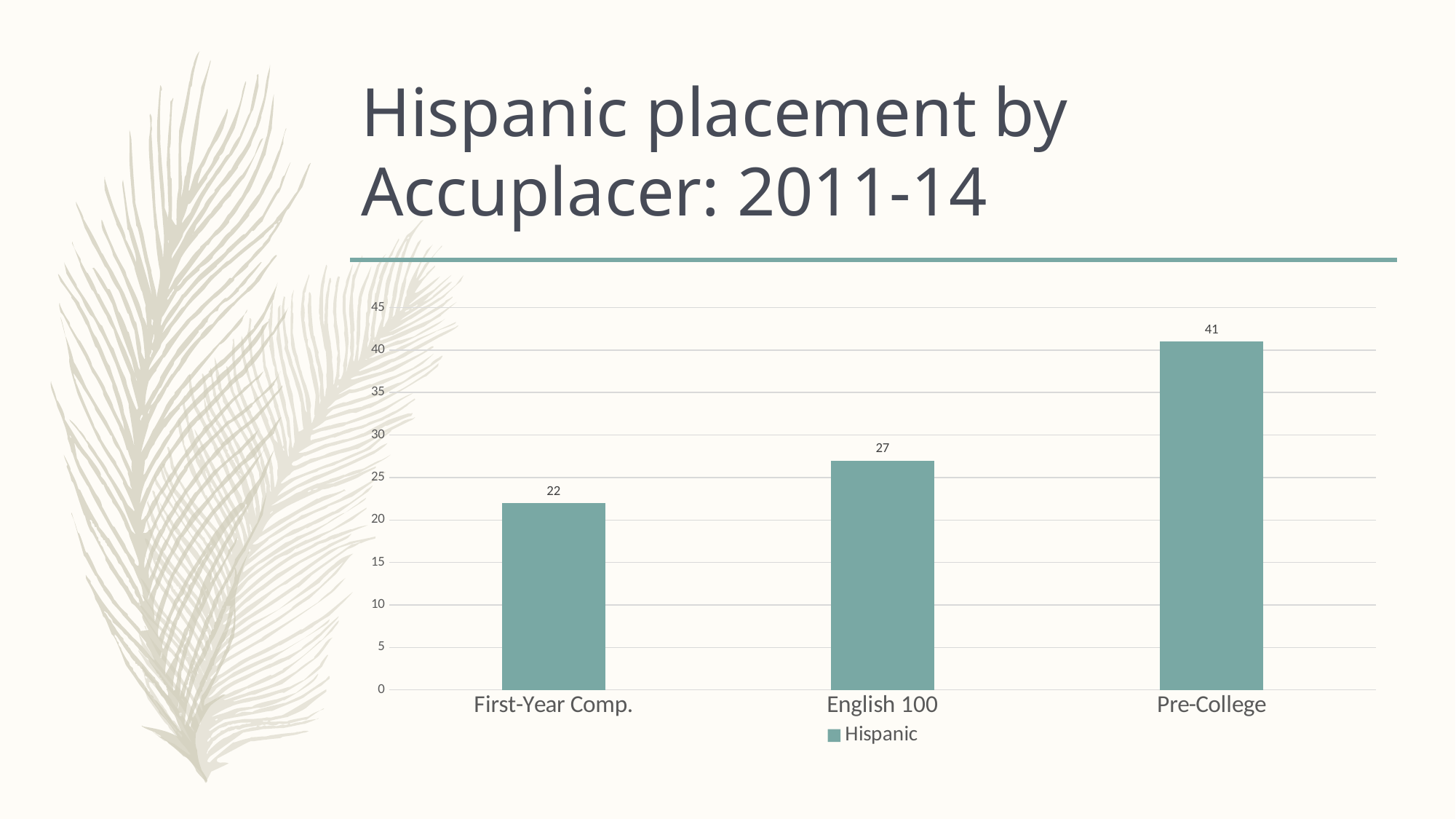
How many categories are shown on the x axis? 3 Is the value for Pre-College greater or less than 40? greater Which category has the highest value? Pre-College What is the value for First-Year Comp.? 22 What is the difference between the values for Pre-College and First-Year Comp.? 19 What is the value for Pre-College? 41 Which is larger, the value for English 100 or the value for Pre-College? Pre-College What series does the legend list? Hispanic What is the difference between the values for English 100 and First-Year Comp.? 5 Which category has the lowest value? First-Year Comp. What is the value for English 100? 27 What kind of chart is shown on the slide? bar chart